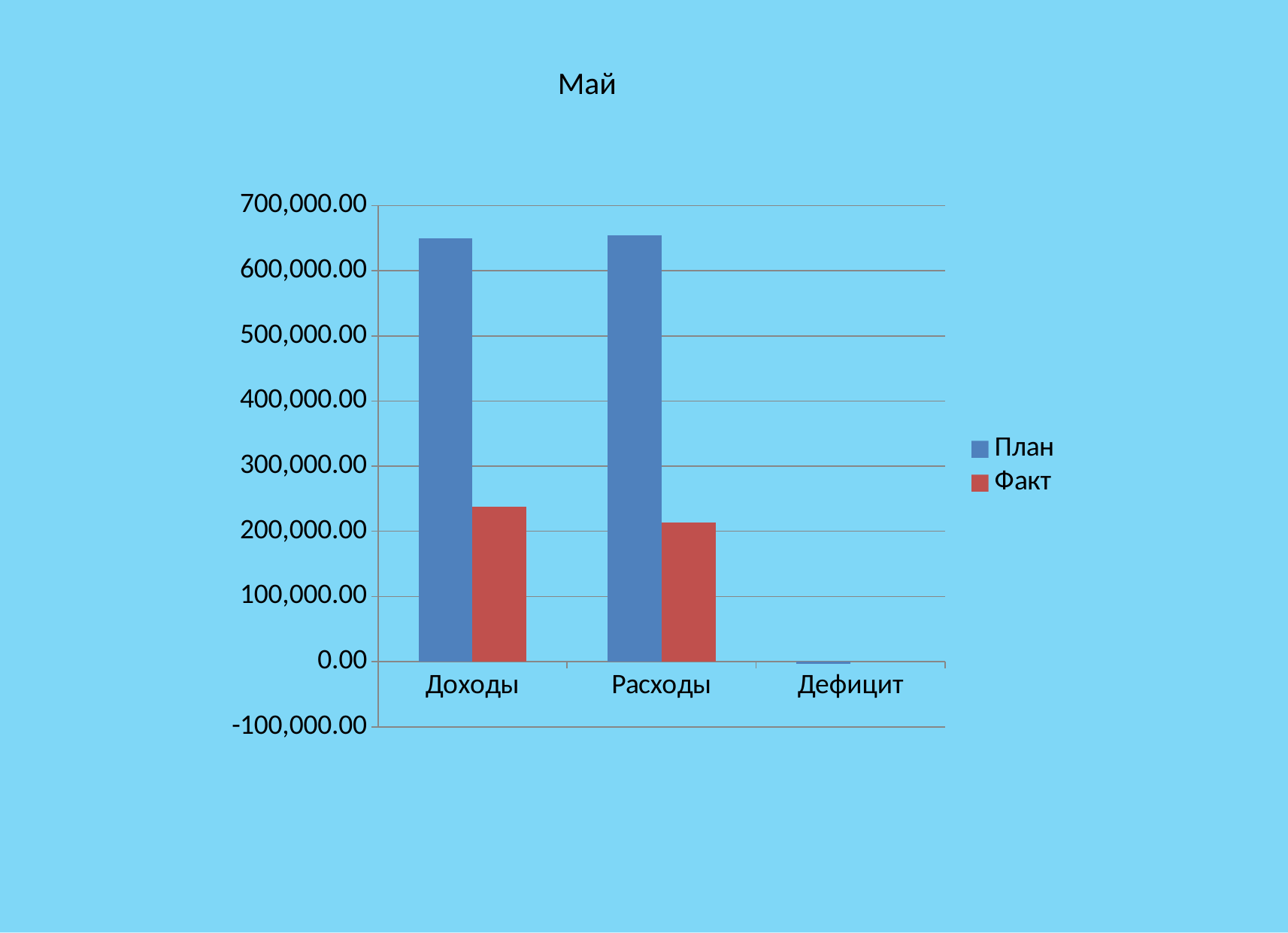
Is the План value for Расходы greater or less than 700,000.00? less What is the title of the chart? Май Is the План value for Доходы greater or less than 600,000.00? greater Is the Факт value for Расходы greater or less than 200,000.00? greater Which category has the lowest План value? Дефицит What kind of chart is shown on the slide? bar chart Which colour represents the Факт series? red How many categories are shown on the x axis? 3 Which category has the highest Факт value? Доходы How many series does the legend list? 2 For Доходы, which is larger: План or Факт? План